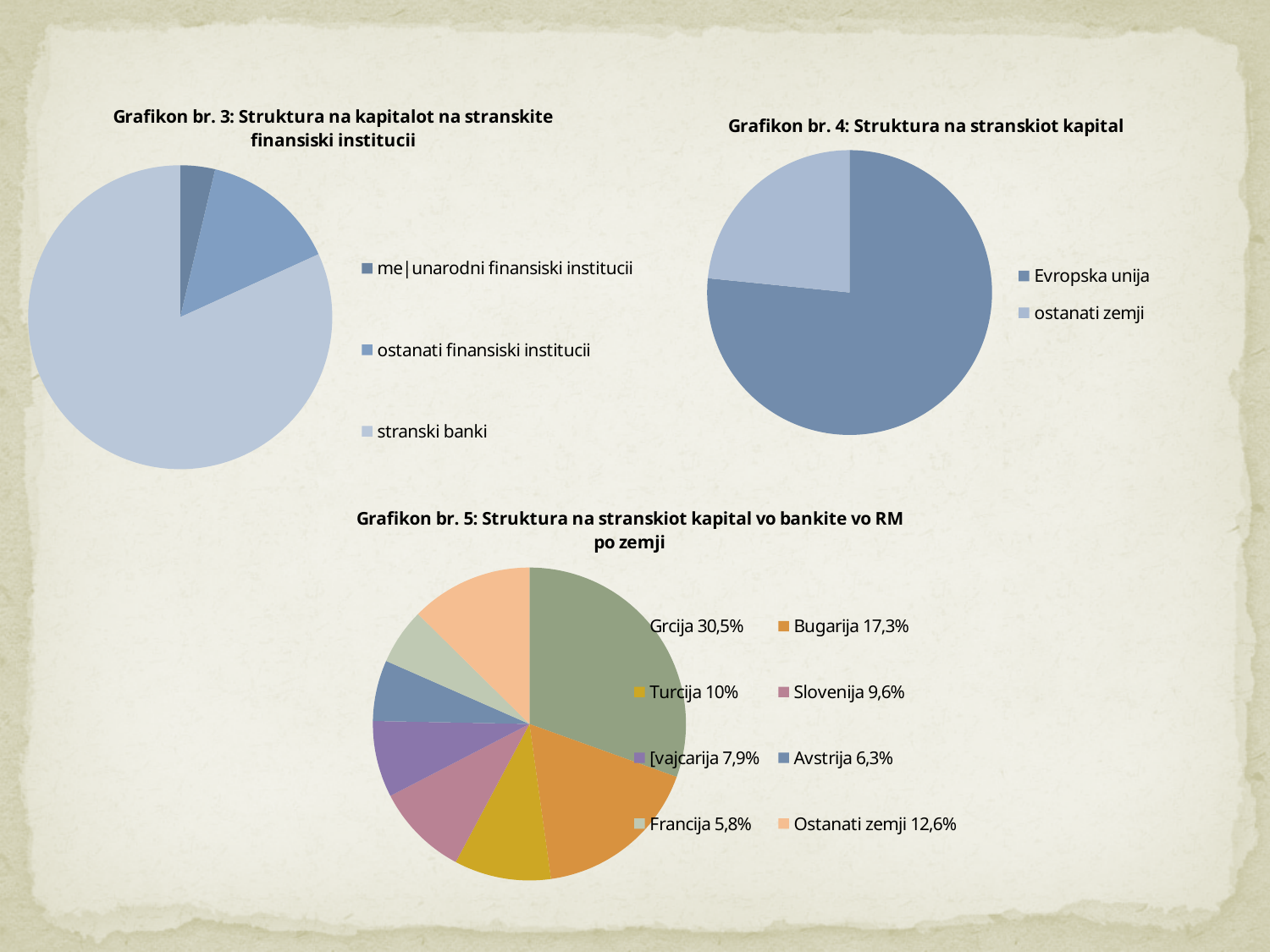
How many categories does the legend of Grafikon br. 3 list? 3 In Grafikon br. 3, which category has the largest slice? stranski banki In Grafikon br. 5, what share does Grcija have? 30,5% In Grafikon br. 5, what is the difference between the shares of Grcija and Bugarija? 13,2% In Grafikon br. 5, what share does Avstrija have? 6,3% How many categories does Grafikon br. 4 show? 2 How many categories does the legend of Grafikon br. 5 list? 8 In Grafikon br. 5, which category has the smallest share? Francija In Grafikon br. 5, which country has the largest share? Grcija In Grafikon br. 4, which category has the largest slice? Evropska unija What kind of chart is Grafikon br. 3? pie chart In Grafikon br. 3, which slice is larger: ostanati finansiski institucii or stranski banki? stranski banki